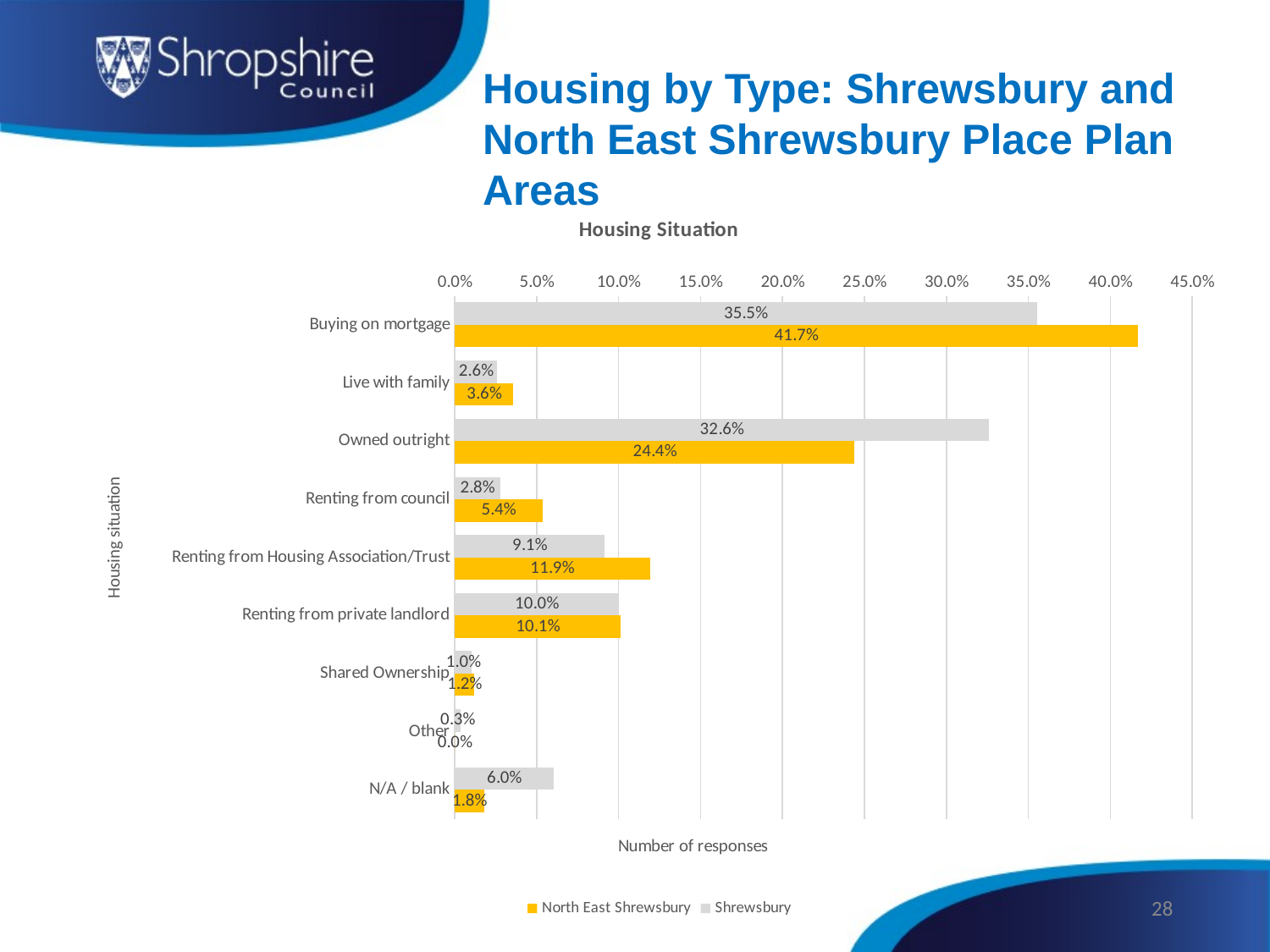
How many housing situation categories are shown on the chart? 9 Which housing situation has the lowest value in the North East Shrewsbury series? Other What is the value for N/A / blank in the Shrewsbury series? 6.0% Which colour represents the North East Shrewsbury series? Yellow How many series does the legend list? 2 What is the value for Renting from Housing Association/Trust in the North East Shrewsbury series? 11.9% For Renting from council, which series has the larger value, North East Shrewsbury or Shrewsbury? North East Shrewsbury What is the value for Owned outright in the Shrewsbury series? 32.6% What is the difference between the North East Shrewsbury and Shrewsbury values for Owned outright? 8.2% What is the value for Buying on mortgage in the North East Shrewsbury series? 41.7% Which housing situation has the highest value in the Shrewsbury series? Buying on mortgage What kind of chart is shown on the slide? Bar chart